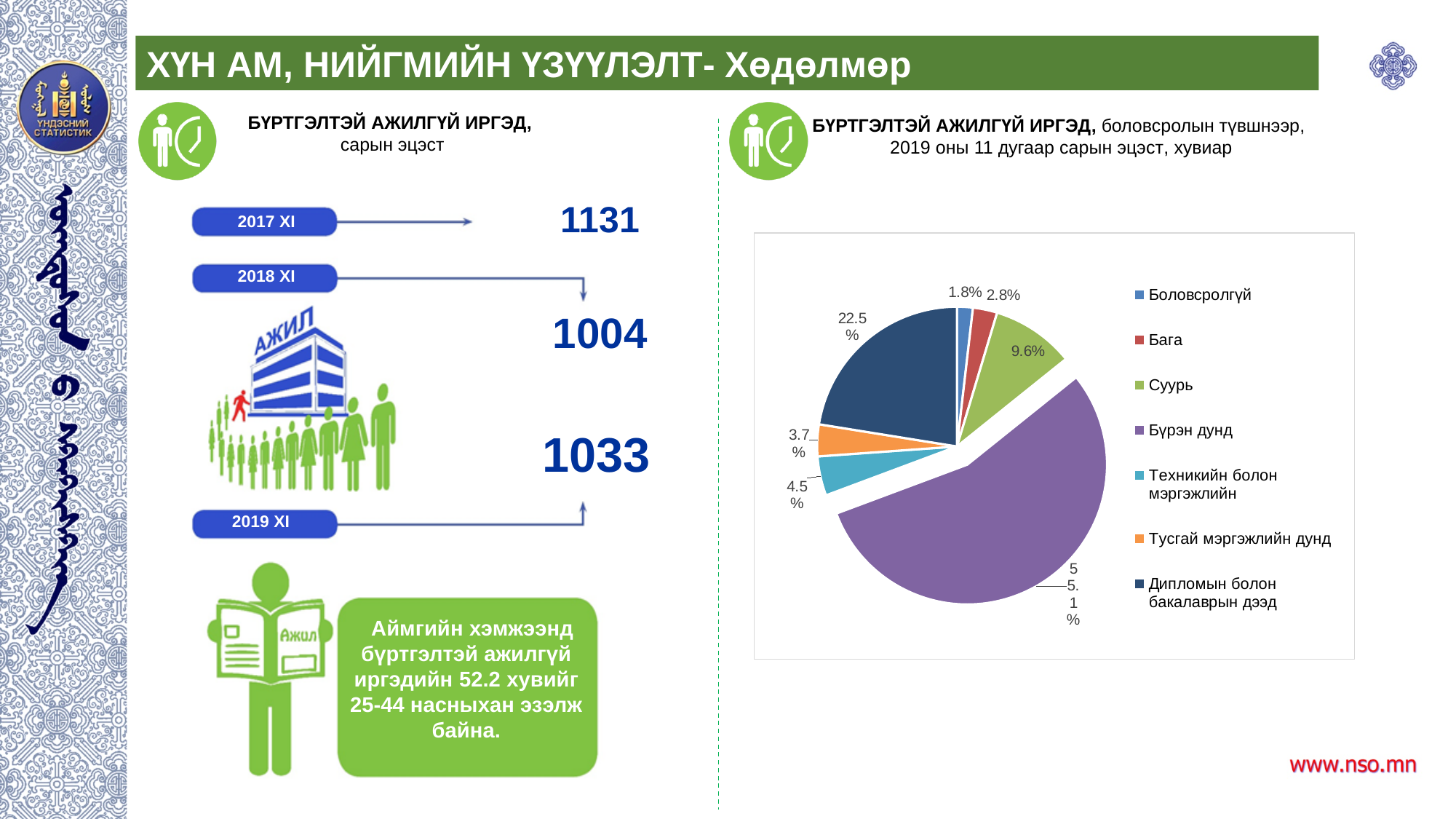
In the pie chart, what share is labelled for Бүрэн дунд? 55.1% In the pie chart, what share is labelled for Тусгай мэргэжлийн дунд? 3.7% In the pie chart, what share is labelled for Техникийн болон мэргэжлийн? 4.5% In the pie chart, what colour is the slice for Бүрэн дунд? purple Which category has the largest slice in the pie chart? Бүрэн дунд In the pie chart, what is the difference between the shares for Бүрэн дунд and Дипломын болон бакалаврын дээд? 32.6% What kind of chart is shown on the right side of the slide? pie chart In the pie chart, what share is labelled for Суурь? 9.6% In the pie chart, what share is labelled for Дипломын болон бакалаврын дээд? 22.5% How many categories does the pie chart on the right show? 7 In the pie chart, which is larger: the share for Бага or the share for Боловсролгүй? Бага Which category has the smallest slice in the pie chart? Боловсролгүй